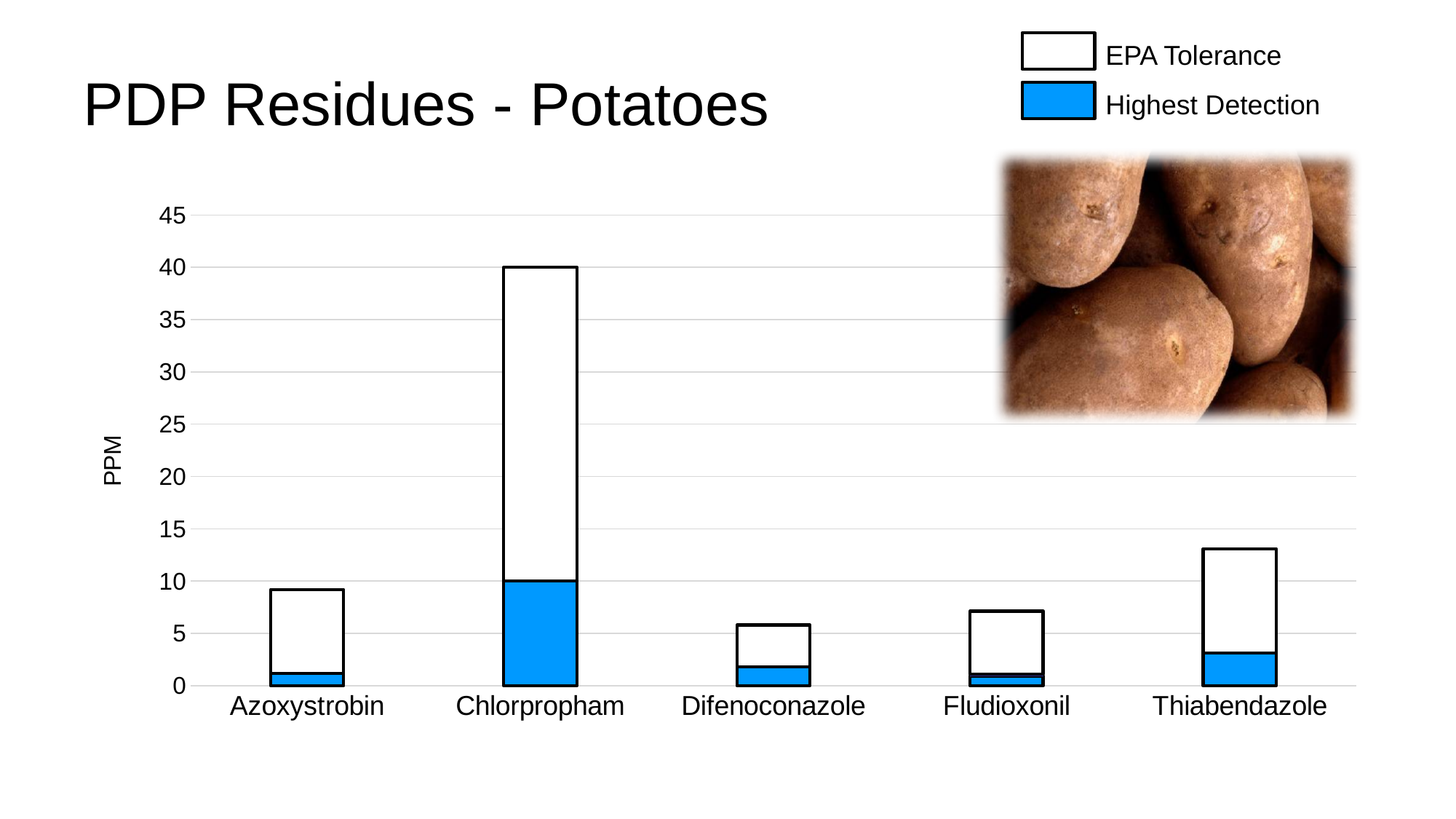
Which has a larger EPA Tolerance, Azoxystrobin or Thiabendazole? Thiabendazole How many series does the legend list? 2 Which pesticide has the lowest EPA Tolerance? Difenoconazole What is the EPA Tolerance for Chlorpropham in PPM? 30 What kind of chart is shown on the slide? bar chart Which pesticide has the highest EPA Tolerance? Chlorpropham Which pesticide has the highest Highest Detection value? Chlorpropham What is the label on the y axis? PPM What is the Highest Detection for Chlorpropham in PPM? 10 Is the Highest Detection for Fludioxonil greater or less than 5? less How many pesticide categories are shown on the x axis? 5